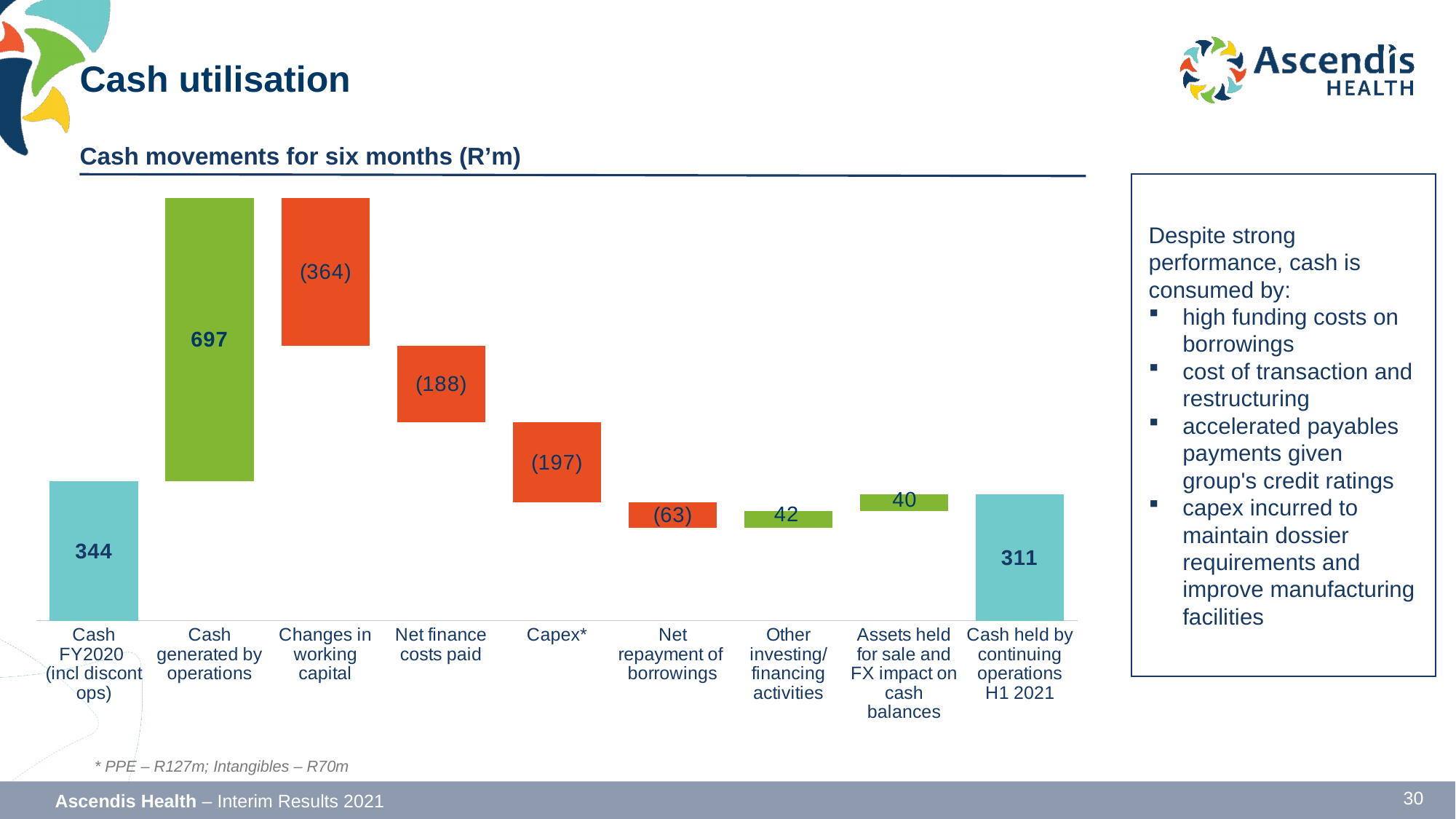
What is the difference between Cash FY2020 (incl discont ops) and Cash held by continuing operations H1 2021? 33 Which is larger in magnitude, Capex* or Net finance costs paid? Capex* How many categories are shown on the x axis? 9 Which category has the largest negative value (largest outflow)? Changes in working capital What is the title of the chart? Cash movements for six months (R'm) What is the value for Cash generated by operations? 697 Which category has the largest positive value? Cash generated by operations What is the value for Net repayment of borrowings? (63) What is the value for Changes in working capital? (364) What kind of chart is shown on the slide? Waterfall bar chart What is the value for Net finance costs paid? (188) What is the value for Cash held by continuing operations H1 2021? 311